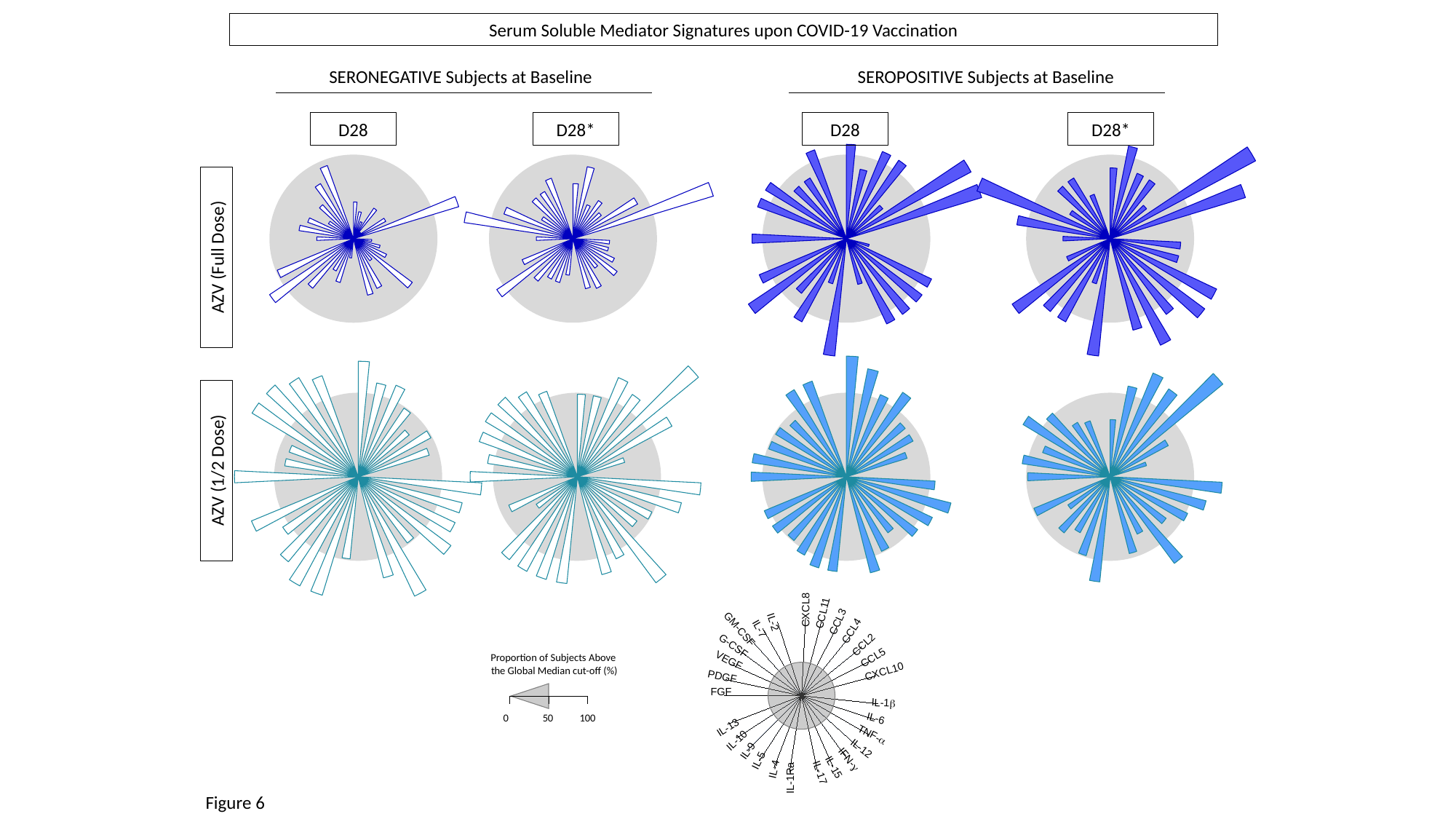
How many radial bar charts of mediator signatures are shown on the slide (excluding the label key)? 8 What kind of chart is used to show the serum soluble mediator signatures on this slide? radial bar chart What are the two baseline subject groups that the charts are divided into? SERONEGATIVE Subjects at Baseline and SEROPOSITIVE Subjects at Baseline Which chart has more bars extending beyond the 50 gray circle: SERONEGATIVE AZV (Full Dose) D28 or SERONEGATIVE AZV (1/2 Dose) D28? SERONEGATIVE AZV (1/2 Dose) D28 What figure number is given at the bottom left of the slide? Figure 6 What is the title shown at the top of the slide? Serum Soluble Mediator Signatures upon COVID-19 Vaccination What is the maximum value shown on the legend scale? 100 What quantity does the legend say the bar length represents? Proportion of Subjects Above the Global Median cut-off (%) In the SERONEGATIVE AZV (Full Dose) D28 chart, are most bars greater or less than 50? less How many soluble mediators are labelled in the key chart at the bottom of the slide? 27 What are the two dose groups labelled on the rows of charts? AZV (Full Dose) and AZV (1/2 Dose) What are the two time-point labels shown above each pair of charts? D28 and D28*